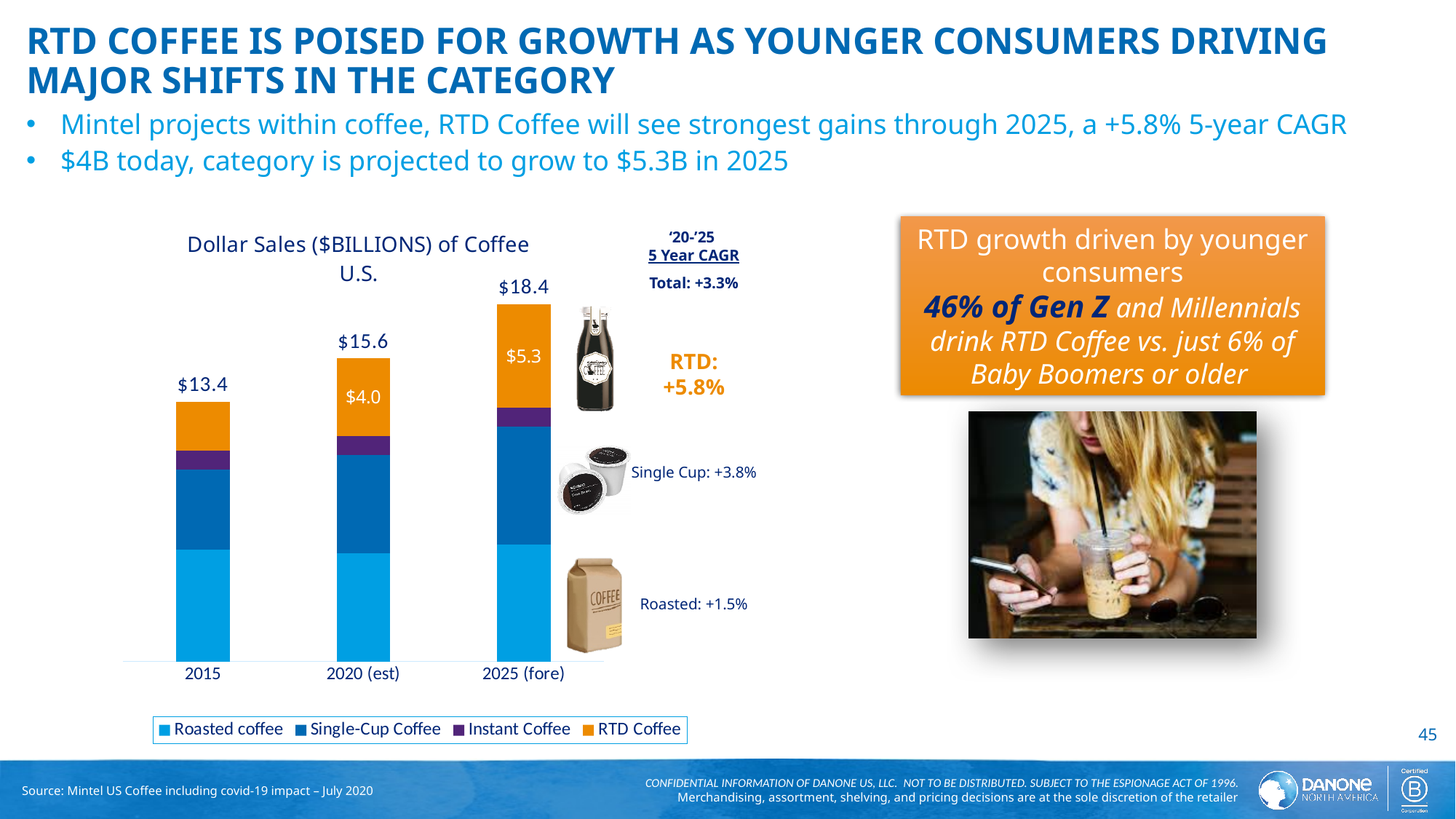
What is the total dollar sales value shown for 2020 (est)? $15.6 What is the total dollar sales value shown for 2015? $13.4 What is the RTD Coffee value labelled on the 2025 (fore) bar? $5.3 How many series does the legend list? 4 What is the RTD Coffee value labelled on the 2020 (est) bar? $4.0 What is the total dollar sales value shown for 2025 (fore)? $18.4 Do total dollar sales rise or fall from 2015 to 2025 (fore)? Rise What kind of chart is used to show dollar sales of coffee? Stacked bar chart Which year has the lowest total dollar sales? 2015 What is the difference between the RTD Coffee values for 2025 (fore) and 2020 (est)? $1.3 Which year has the highest total dollar sales? 2025 (fore) What is the difference between the total dollar sales for 2025 (fore) and 2015? $5.0